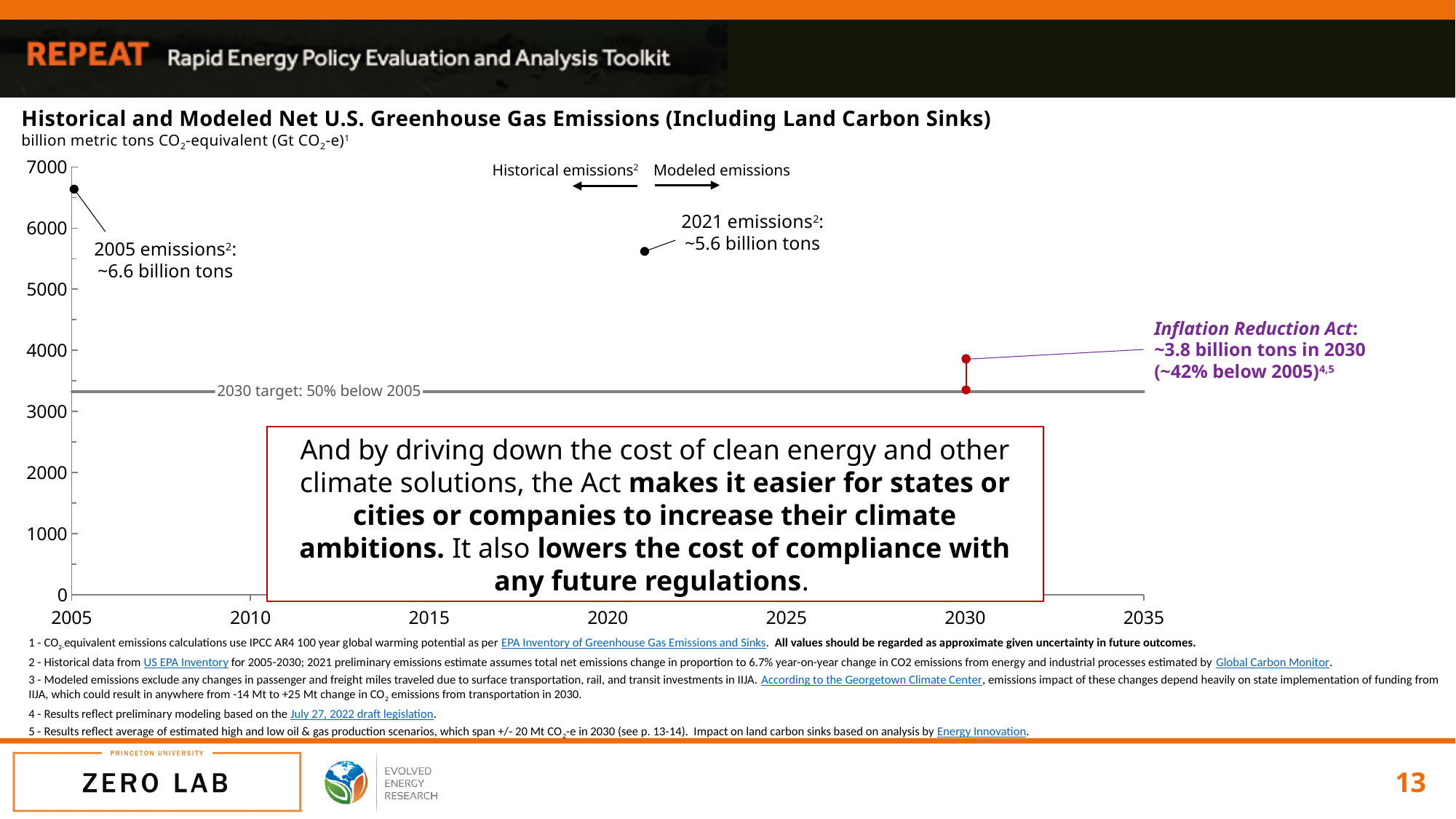
What does the horizontal gray line across the chart represent? 2030 target: 50% below 2005 Is the value for 2021 emissions greater or less than 5000? greater How many years are labeled on the x axis? 7 Is the Inflation Reduction Act point for 2030 greater or less than 4000? less Is the 2030 target line greater or less than 3000? greater Which is larger, the 2005 emissions point or the 2021 emissions point? 2005 emissions What is the title of the chart? Historical and Modeled Net U.S. Greenhouse Gas Emissions (Including Land Carbon Sinks) Which plotted year has the highest emissions value? 2005 Do the plotted emissions values rise or fall from 2005 to 2030? fall Which is higher on the chart, the Inflation Reduction Act point in 2030 or the 2030 target line? Inflation Reduction Act point Which plotted year has the lowest emissions value? 2030